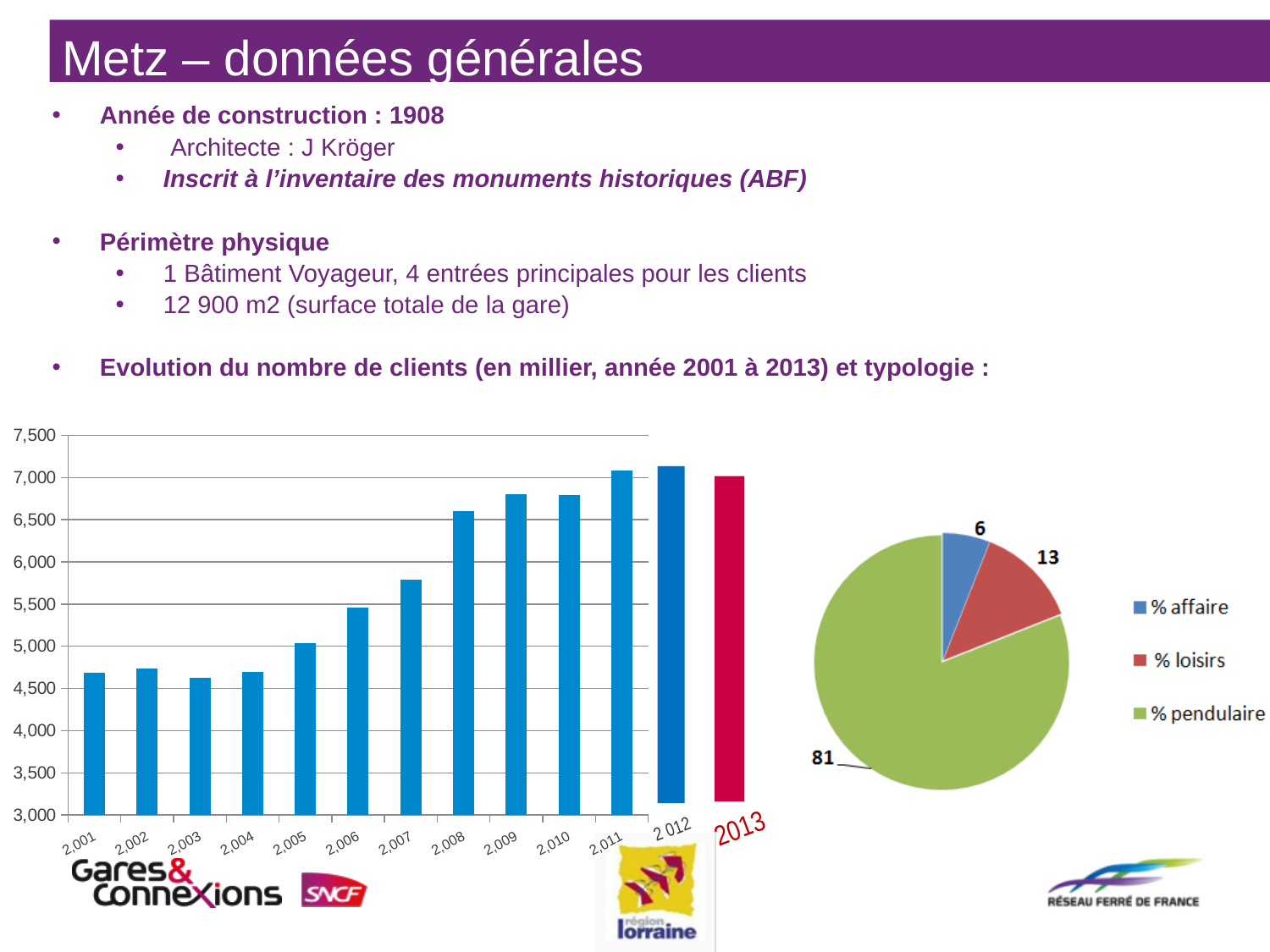
In the bar chart on the left, is the value for 2001 greater or less than 5,000? less In the bar chart on the left, do the values generally rise or fall from 2001 to 2013? rise How many entries does the legend of the pie chart on the right list? 3 In the pie chart on the right, which category has the smallest slice? % affaire In the pie chart on the right, what is the difference between the values for % pendulaire and % loisirs? 68 In the pie chart on the right, what is the value shown for % pendulaire? 81 In the pie chart on the right, what is the value shown for % affaire? 6 How many bars does the bar chart on the left show? 13 In the pie chart on the right, what is the value shown for % loisirs? 13 In the bar chart on the left, is the value for 2008 greater or less than 6,500? greater What kind of chart is the chart on the left of the slide? bar chart In the pie chart on the right, which category has the largest slice? % pendulaire